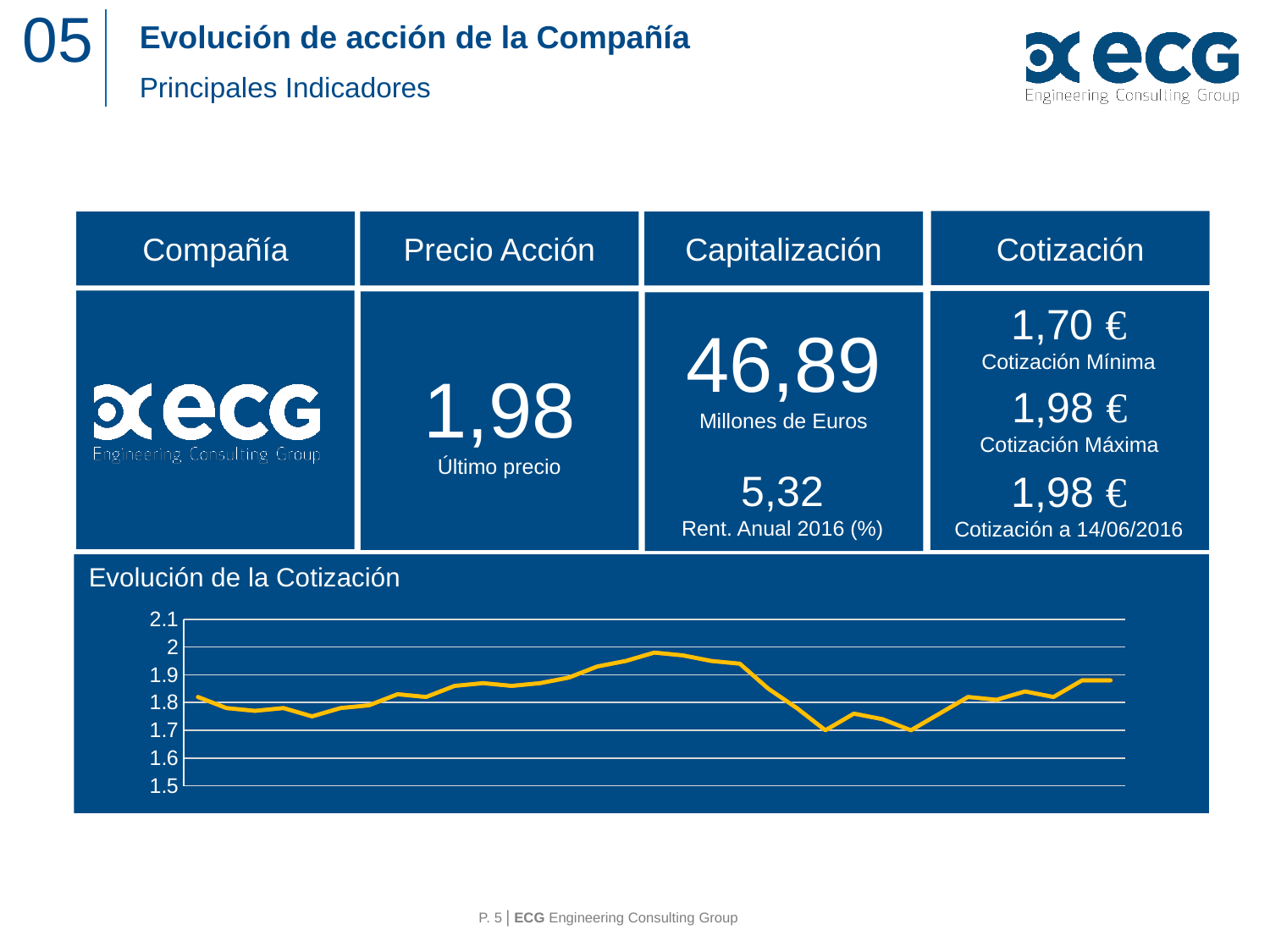
In the 'Evolución de la Cotización' chart, is the highest point of the line greater or less than 1.9? greater What is the title of the line chart on the slide? Evolución de la Cotización In the 'Evolución de la Cotización' chart, does the line rise or fall from its lowest point to the end of the series? rise In the 'Evolución de la Cotización' chart, is the last point of the line greater or less than 1.8? greater In the 'Evolución de la Cotización' chart, does the line rise or fall from its peak to the lowest point that follows it? fall What colour is the line in the 'Evolución de la Cotización' chart? yellow In the 'Evolución de la Cotización' chart, is the first point of the line greater or less than 1.9? less What kind of chart is shown under 'Evolución de la Cotización'? line chart In the 'Evolución de la Cotización' chart, is the last point of the line higher or lower than the first point? higher How many series are plotted in the 'Evolución de la Cotización' chart? 1